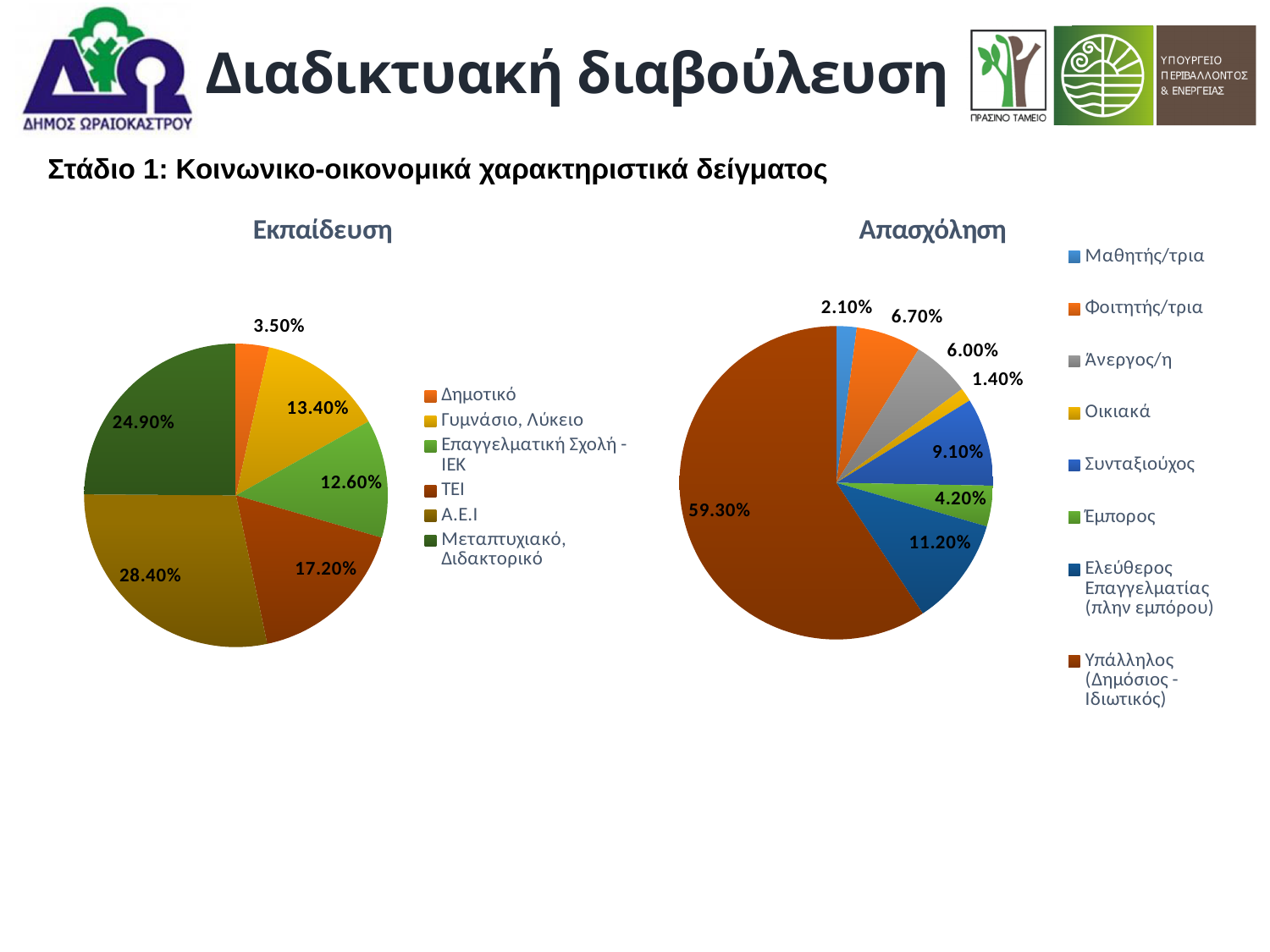
In the Εκπαίδευση chart, how many categories does the legend list? 6 In the Εκπαίδευση chart, what share is shown for Α.Ε.Ι? 28.40% In the Απασχόληση chart, which is larger: Φοιτητής/τρια or Άνεργος/η? Φοιτητής/τρια In the Απασχόληση chart, which category has the smallest share? Οικιακά In the Εκπαίδευση chart, what share is shown for Δημοτικό? 3.50% In the Απασχόληση chart, what share is shown for Υπάλληλος (Δημόσιος - Ιδιωτικός)? 59.30% In the Εκπαίδευση chart, which category has the largest share? Α.Ε.Ι In the Απασχόληση chart, how many categories does the legend list? 8 In the Εκπαίδευση chart, what is the difference between the shares for ΤΕΙ and Επαγγελματική Σχολή - ΙΕΚ? 4.60% In the Εκπαίδευση chart, which category has the smallest share? Δημοτικό In the Απασχόληση chart, what share is shown for Συνταξιούχος? 9.10% What type of chart is the Απασχόληση chart? Pie chart